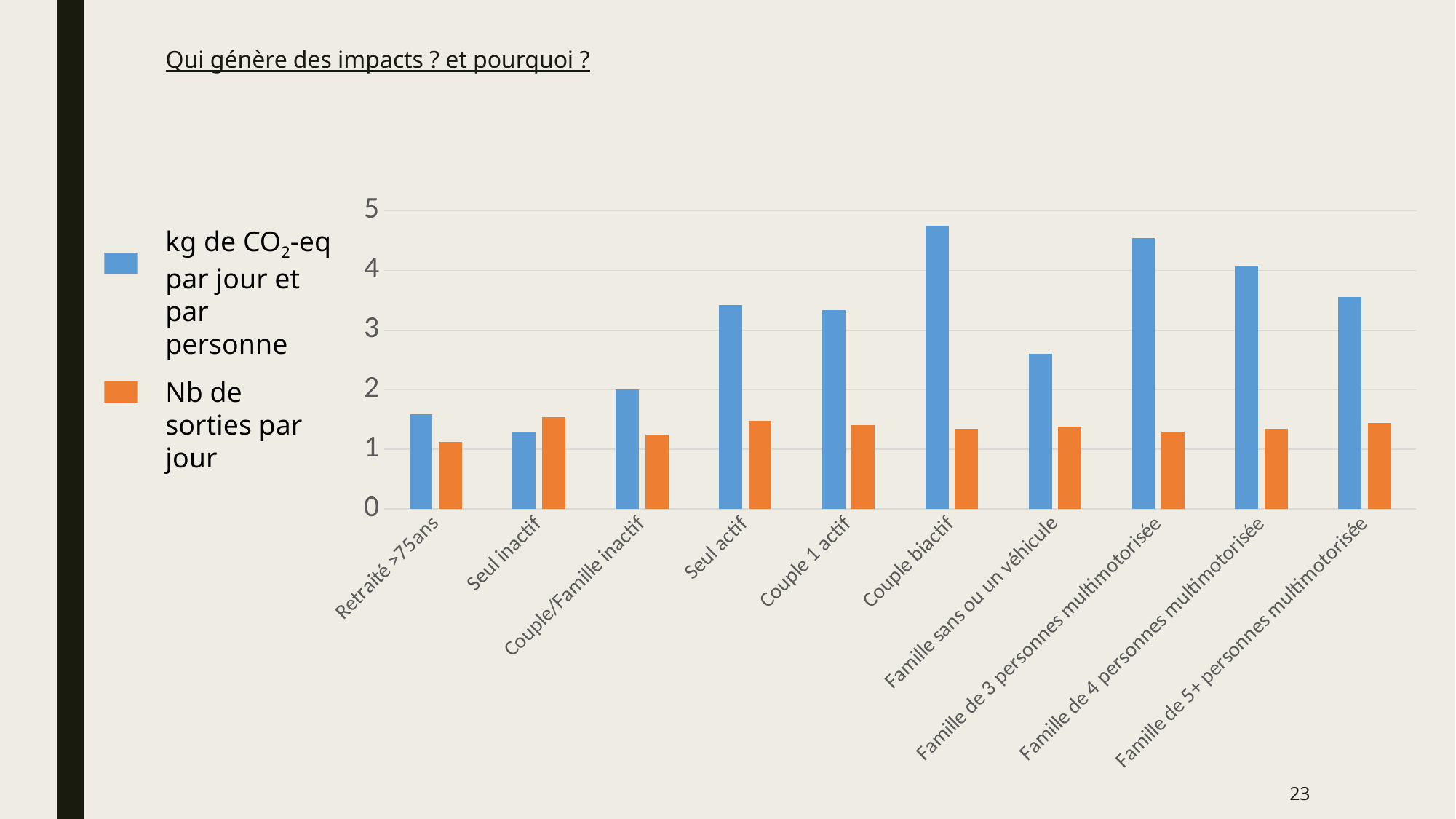
Which category has the lowest value for 'kg de CO2-eq par jour et par personne'? Seul inactif Is the 'kg de CO2-eq par jour et par personne' value for Couple biactif greater or less than 4? greater Is the 'kg de CO2-eq par jour et par personne' value for Famille sans ou un véhicule greater or less than 3? less Which colour represents the 'Nb de sorties par jour' series? orange How many categories are shown on the x axis? 10 How many series does the legend list? 2 Is the 'Nb de sorties par jour' value for Seul inactif greater or less than 2? less Which has the larger 'kg de CO2-eq par jour et par personne' value: Famille de 3 personnes multimotorisée or Famille de 4 personnes multimotorisée? Famille de 3 personnes multimotorisée For Seul inactif, which series has the larger value: 'kg de CO2-eq par jour et par personne' or 'Nb de sorties par jour'? Nb de sorties par jour Which category has the highest value for 'kg de CO2-eq par jour et par personne'? Couple biactif What kind of chart is shown on the slide? bar chart